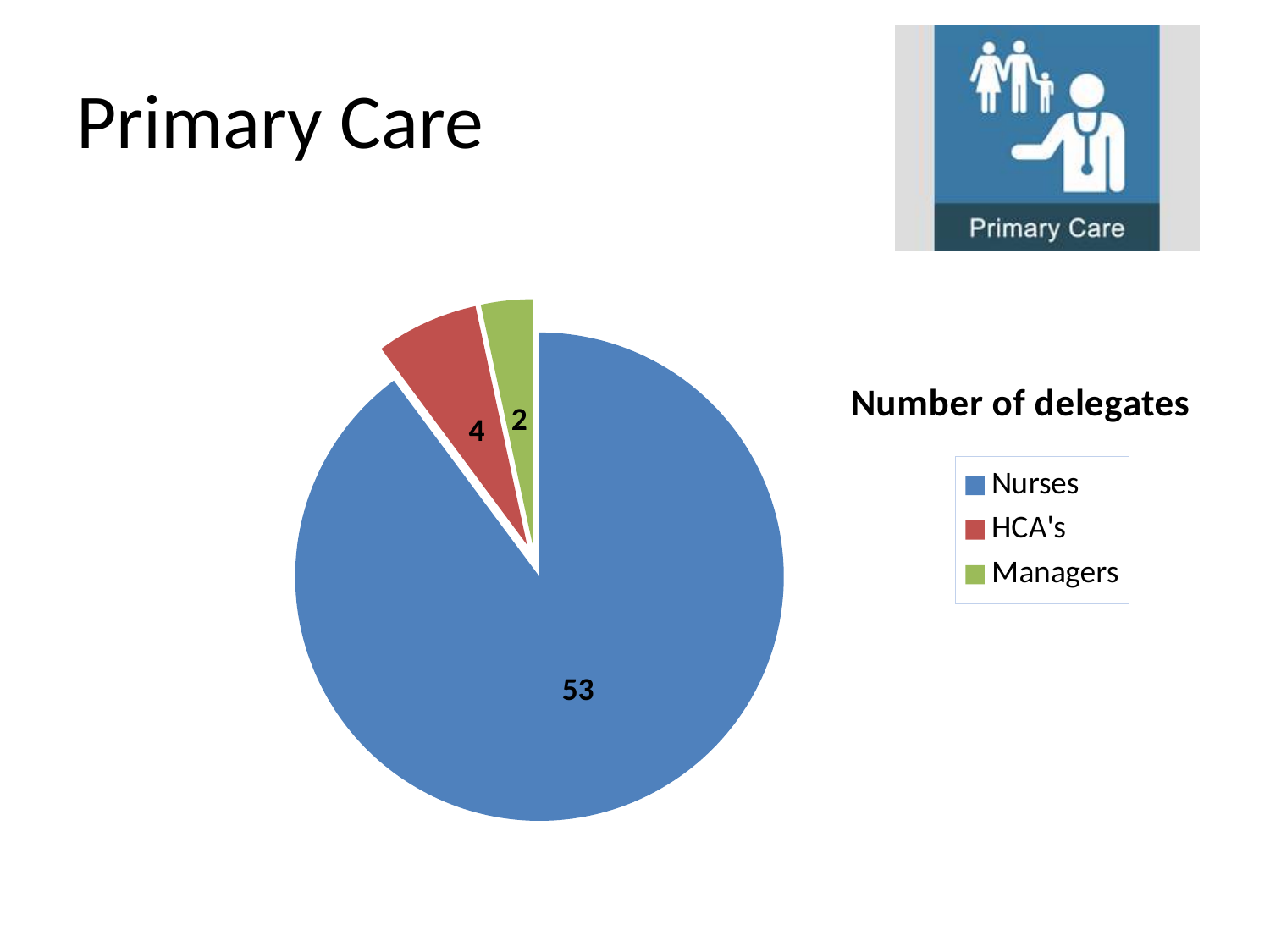
How many delegates are Nurses? 53 What is the total number of delegates across all slices? 59 How many delegates are HCA's? 4 Which category has the smallest number of delegates? Managers Which category has the largest number of delegates? Nurses How many categories does the pie chart show? 3 Which has more delegates, HCA's or Managers? HCA's What type of chart is shown on the slide? pie chart Which colour represents HCA's in the legend? red What is the difference between the number of Nurses and the number of HCA's? 49 What is the title of the chart? Number of delegates How many delegates are Managers? 2